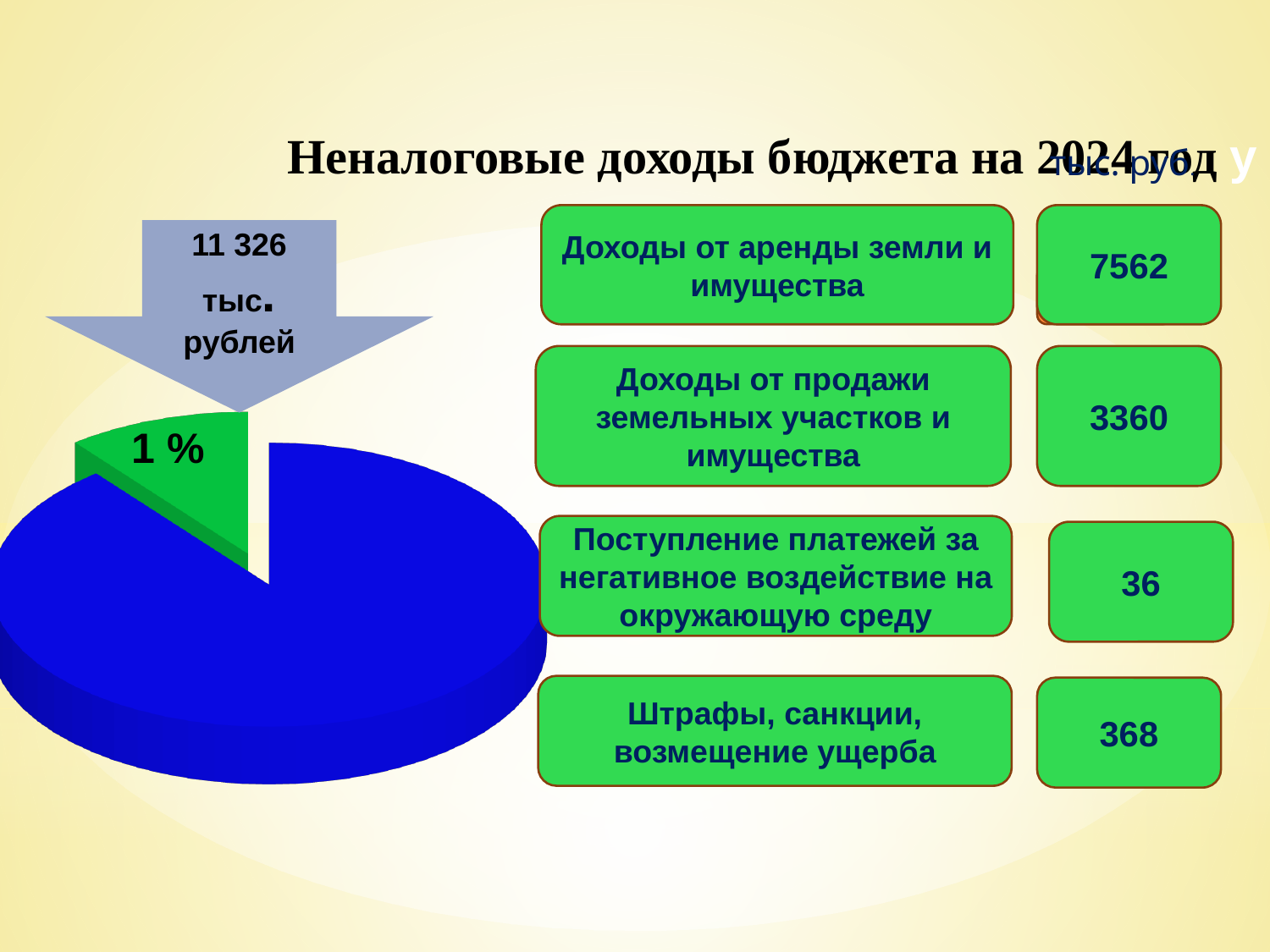
What colour is the slice labelled 1 % in the pie chart? green What total value is shown in the arrow pointing at the pie chart? 11 326 тыс. рублей Which colour slice is the largest in the pie chart? blue Which slice of the pie chart is larger, the blue one or the green one? blue What kind of chart is shown on the slide? pie chart Which colour slice is the smallest in the pie chart? green What share of the pie does the green slice represent? 1 % How many slices does the pie chart have? 2